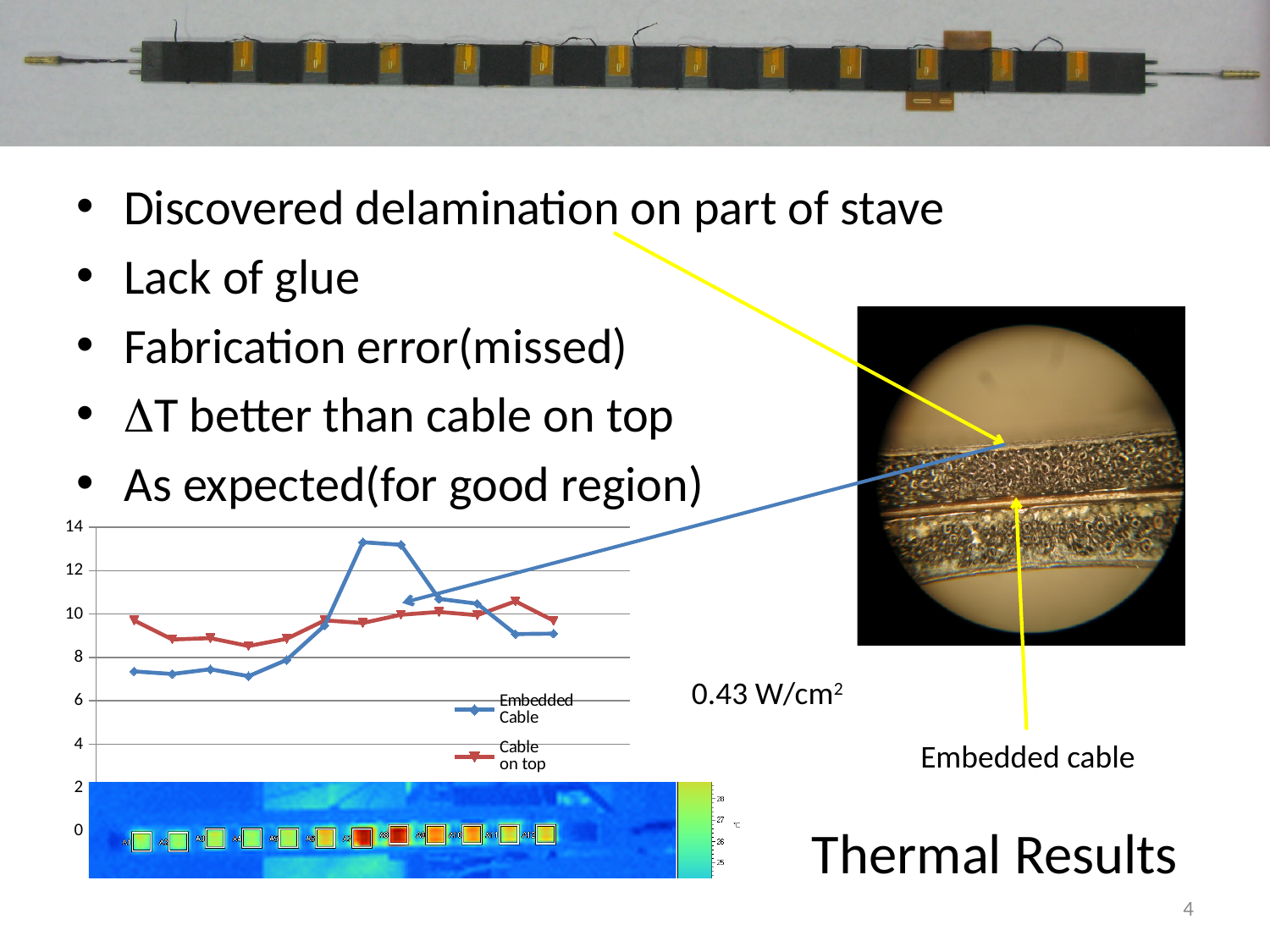
Which series reaches the highest value on the chart? Embedded Cable What is the maximum value shown on the chart's vertical axis? 14 Is the highest value of the Cable on top series greater or less than 12? less Is the first (leftmost) value of the Embedded Cable series greater or less than 8? less Is the lowest value of the Cable on top series greater or less than 8? greater What colour is the Embedded Cable series line in the chart? blue Which series contains the lowest value on the chart? Embedded Cable What kind of chart is shown on the slide? line chart At the leftmost point of the chart, which series has the higher value, Embedded Cable or Cable on top? Cable on top What are the two series named in the chart legend? Embedded Cable and Cable on top How many series does the chart legend list? 2